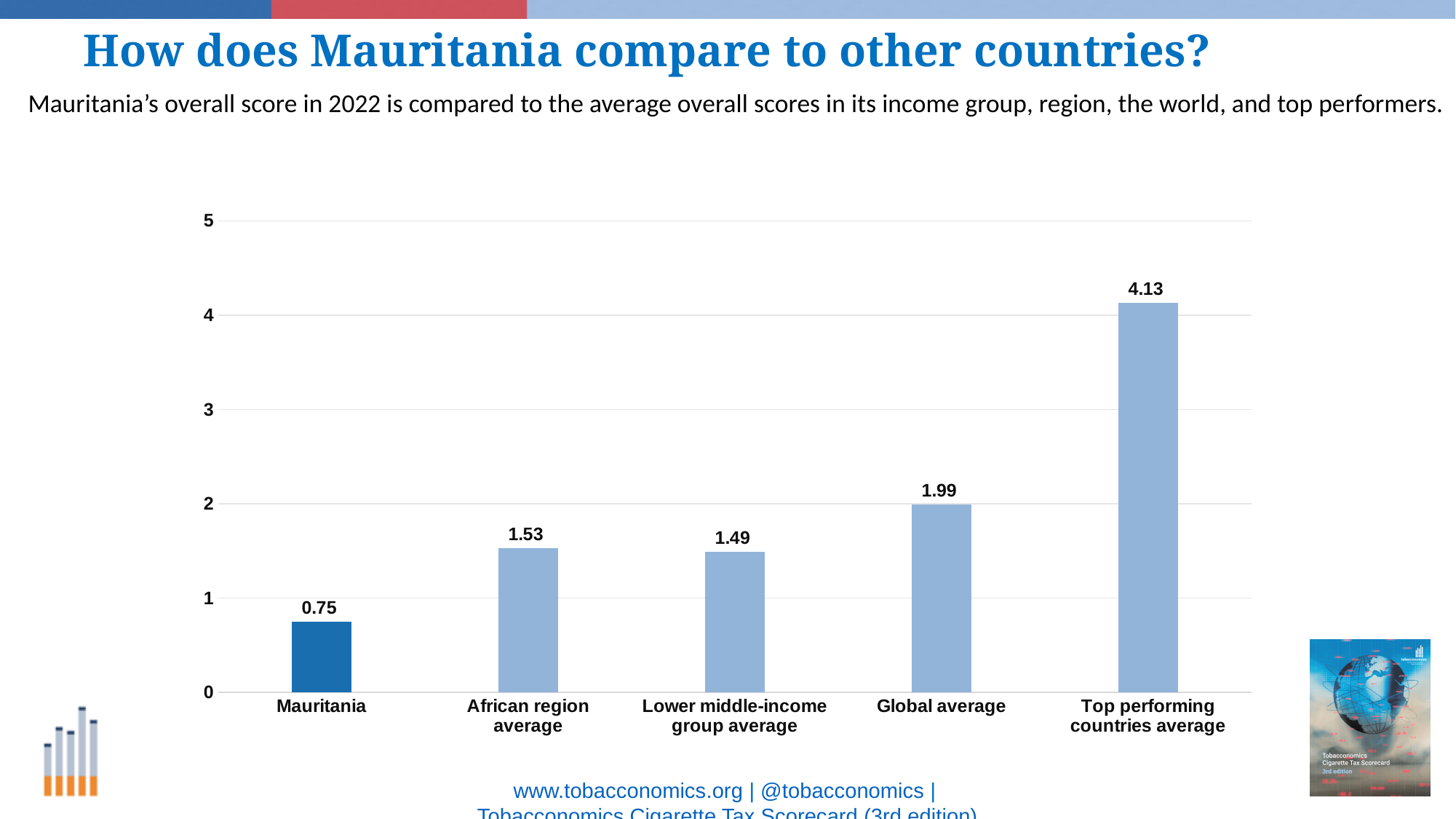
How many bars are shown in the chart? 5 What kind of chart is shown on the slide? Bar chart What is the value shown for the Lower middle-income group average? 1.49 Which is larger, the Global average or the Lower middle-income group average? Global average Which category has the lowest value? Mauritania What is the value shown for the African region average? 1.53 What is the value shown for the Top performing countries average? 4.13 What is the difference between the Top performing countries average and Mauritania's score? 3.38 What is the overall score shown for Mauritania? 0.75 Which category has the highest value? Top performing countries average What is the value shown for the Global average? 1.99 What is the difference between the Global average and the African region average? 0.46